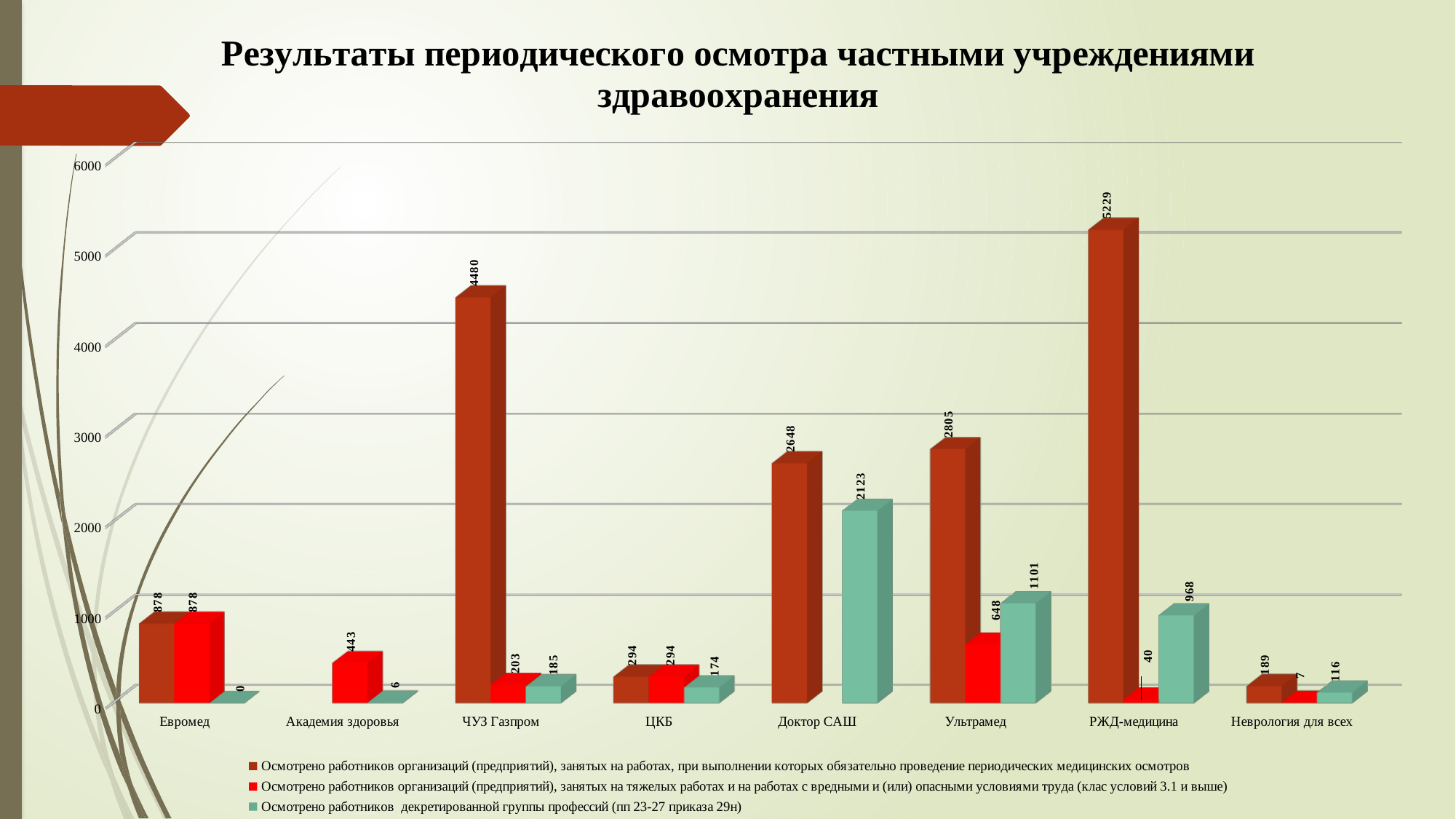
What is the difference between the dark red series values for РЖД-медицина and ЧУЗ Газпром? 749 What is the title of the chart? Результаты периодического осмотра частными учреждениями здравоохранения What type of chart is shown on the slide? bar chart Which is larger: the teal series value for Ультрамед or for РЖД-медицина? Ультрамед Is the dark red series value for Доктор САШ greater or less than 2000? greater What is the value of the dark red series (periodic medical examinations) for РЖД-медицина? 5229 Which institution has the lowest value in the teal series (декретированной группы профессий)? Евромед Which institution has the highest value in the dark red series (periodic medical examinations)? РЖД-медицина How many series does the legend list? 3 How many categories (institutions) are shown on the x axis? 8 What is the value of the teal series (декретированной группы профессий) for Доктор САШ? 2123 What is the value of the red series (тяжелых работах / вредными условиями труда) for Ультрамед? 648